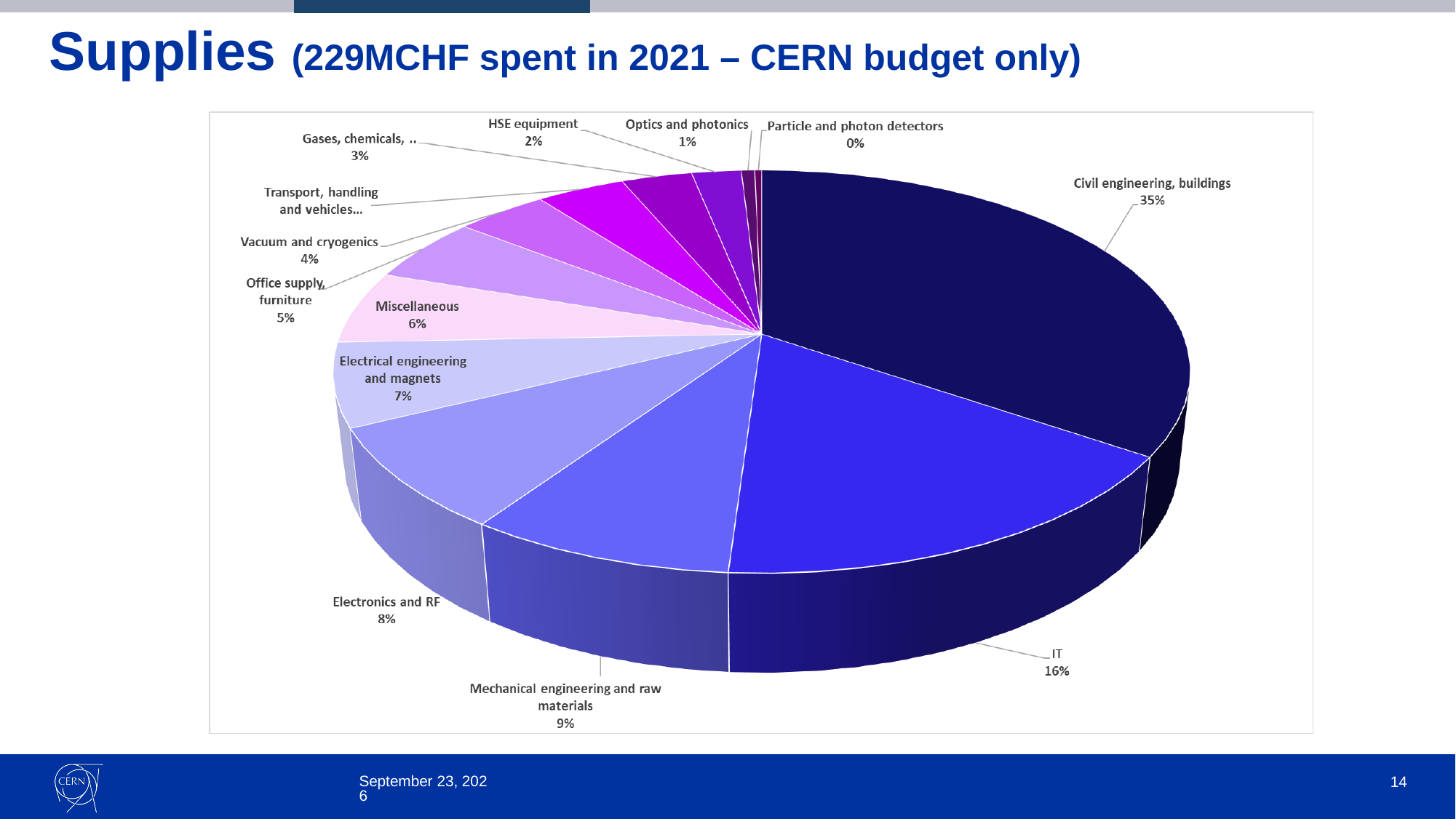
Which category has the largest share of the pie? Civil engineering, buildings What percentage is shown for Vacuum and cryogenics? 4% What percentage is shown for Mechanical engineering and raw materials? 9% What is the difference in percentage points between Civil engineering, buildings and IT? 19 Which is larger, the share for Miscellaneous or the share for Office supply, furniture? Miscellaneous What share of the pie does Civil engineering, buildings account for? 35% How many categories are shown in the pie chart? 13 What is the percentage shown for IT? 16% Which category has the smallest share of the pie? Particle and photon detectors What kind of chart is shown on the slide? Pie chart According to the slide title, how much was spent on supplies in 2021? 229MCHF What percentage is shown for Electronics and RF? 8%